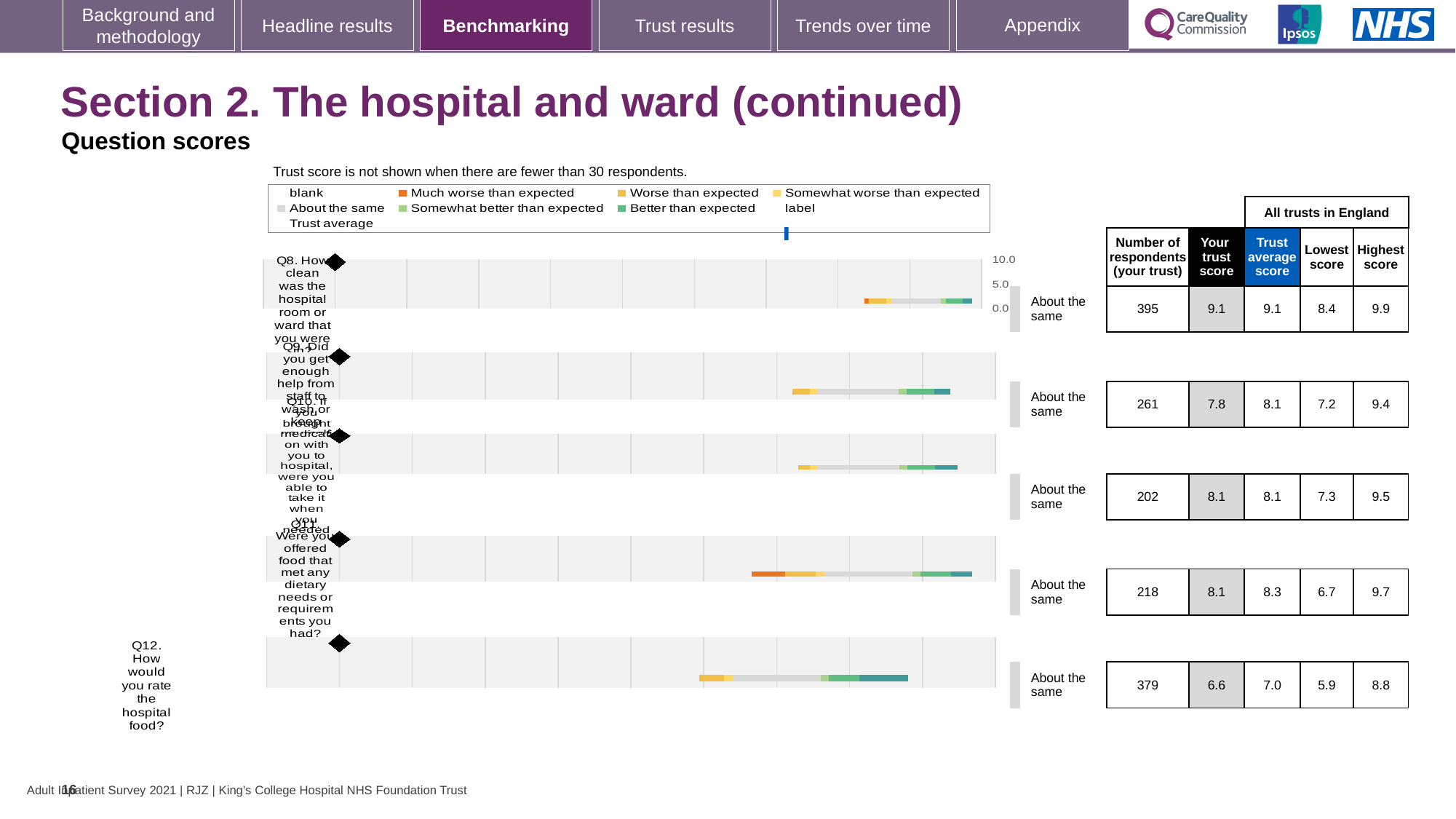
For Q9, which is larger: your trust score or the trust average score? Trust average score What benchmark category is shown for Q12? About the same Which question has the highest 'Your trust score'? Q8 How many respondents from your trust answered Q9? 261 What is the lowest score across all trusts in England for Q12? 5.9 Which question has the lowest 'Your trust score'? Q12 What is the 'Your trust score' for Q8 (How clean was the hospital room or ward)? 9.1 What is the highest score across all trusts in England for Q11? 9.7 For Q12, what is the difference between the trust average score and your trust score? 0.4 What kind of chart is used to show the question scores? Bar chart What is the 'Your trust score' for Q12 (How would you rate the hospital food)? 6.6 How many questions are plotted in the chart? 5